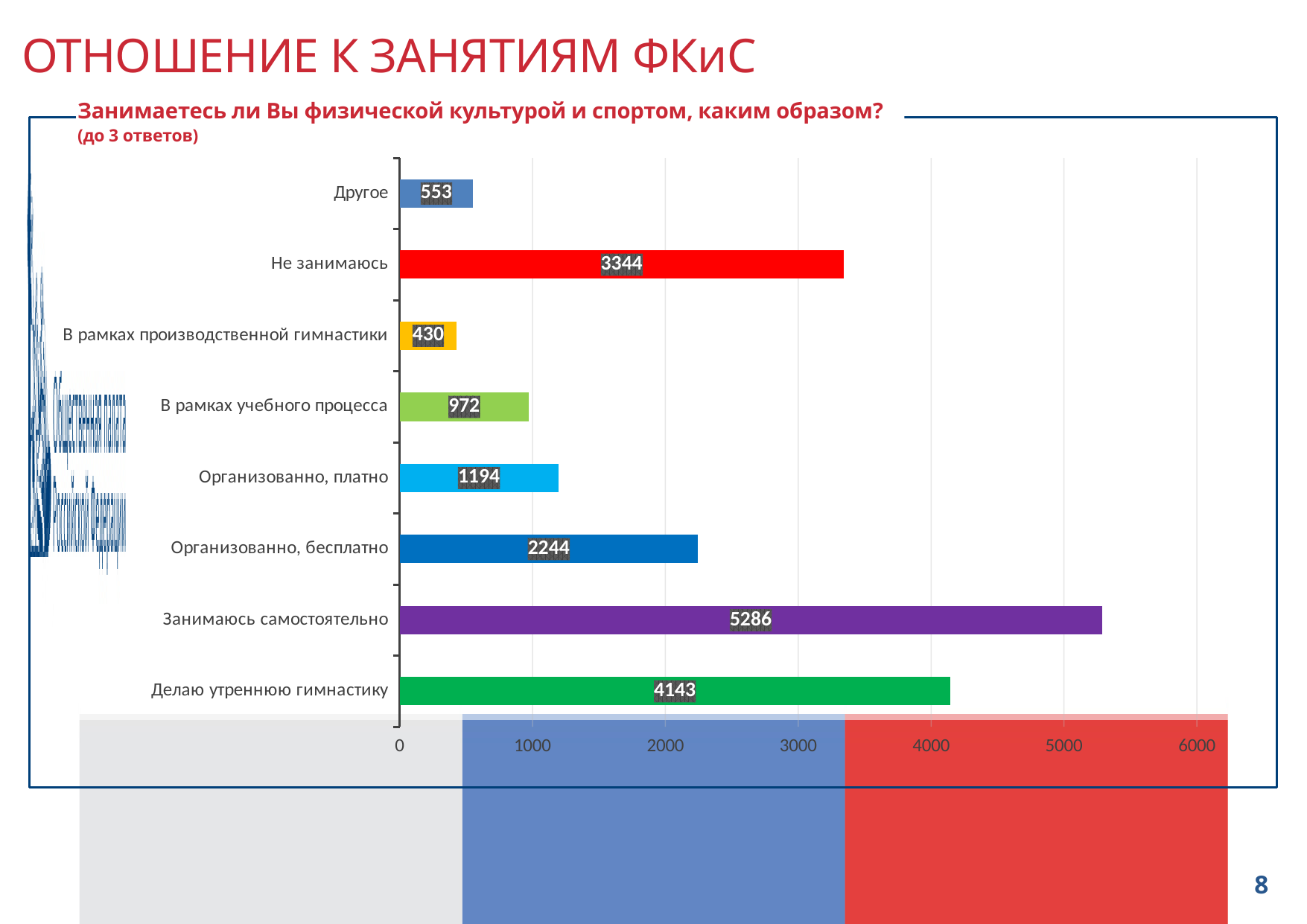
What is the value for "В рамках производственной гимнастики"? 430 Which category has the lowest value? В рамках производственной гимнастики What is the value for "Организованно, платно"? 1194 What is the difference between the values for "Занимаюсь самостоятельно" and "Делаю утреннюю гимнастику"? 1143 Which is larger: the value for "Организованно, бесплатно" or the value for "Организованно, платно"? Организованно, бесплатно What kind of chart is shown on the slide? bar chart How many categories are shown in the chart? 8 What colour is the bar for "Не занимаюсь"? red What is the value for "Занимаюсь самостоятельно"? 5286 What is the value for "Не занимаюсь"? 3344 Which category has the highest value? Занимаюсь самостоятельно Is the value for "Делаю утреннюю гимнастику" greater or less than 4000? greater